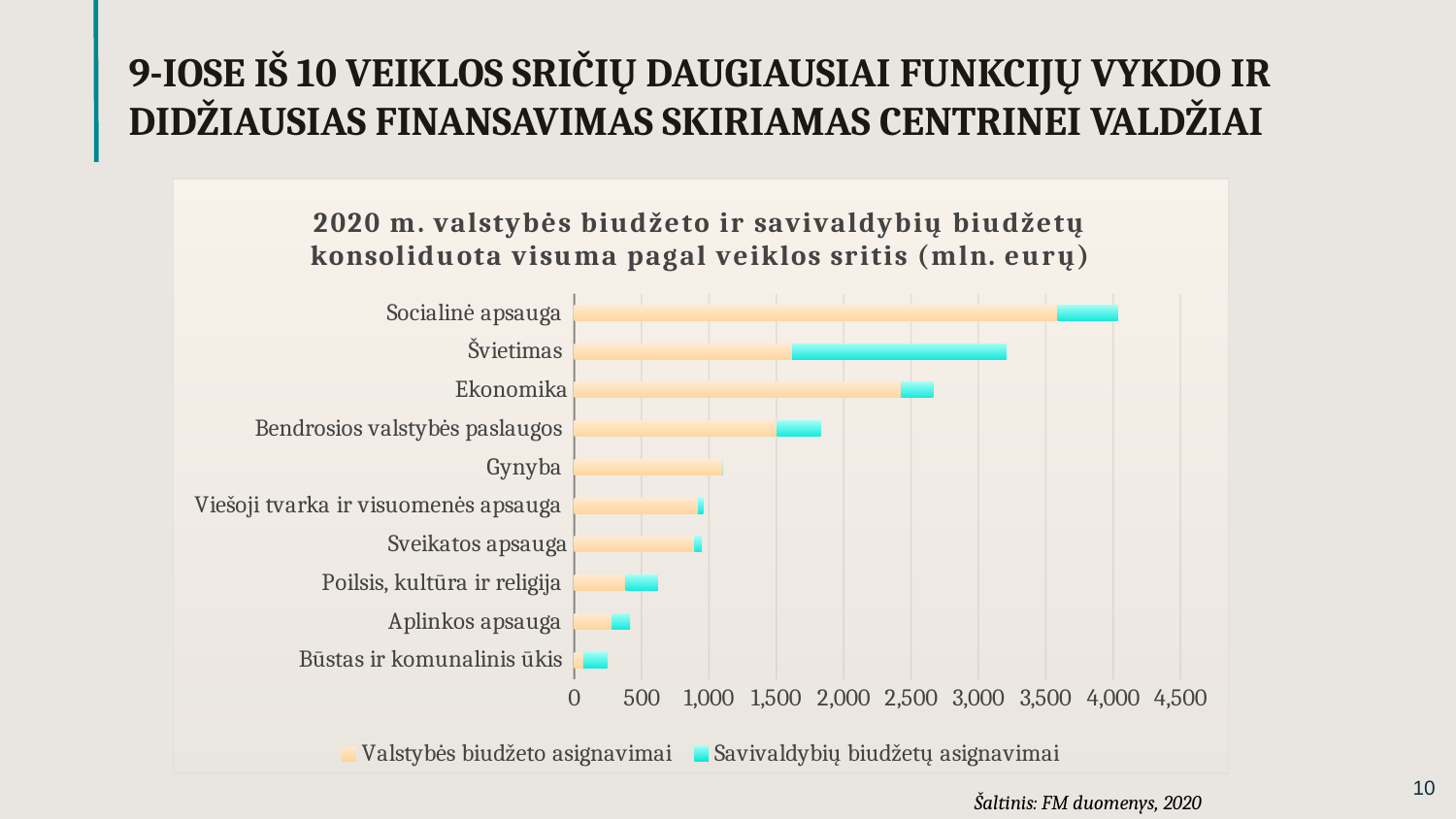
Is the total value for Socialinė apsauga greater or less than 3,500? greater Is the total value for Švietimas greater or less than 3,000? greater What kind of chart is shown on the slide? Stacked horizontal bar chart How many activity areas (categories) are shown in the chart? 10 Which activity area has the largest Savivaldybių biudžetų asignavimai (municipal budget) portion? Švietimas Is the total value for Bendrosios valstybės paslaugos greater or less than 1,500? greater What are the two series named in the chart legend? Valstybės biudžeto asignavimai and Savivaldybių biudžetų asignavimai How many series does the chart legend list? 2 Which activity area has the lowest total consolidated budget? Būstas ir komunalinis ūkis Which has a larger total budget, Švietimas or Ekonomika? Švietimas Which activity area has the highest total consolidated budget? Socialinė apsauga